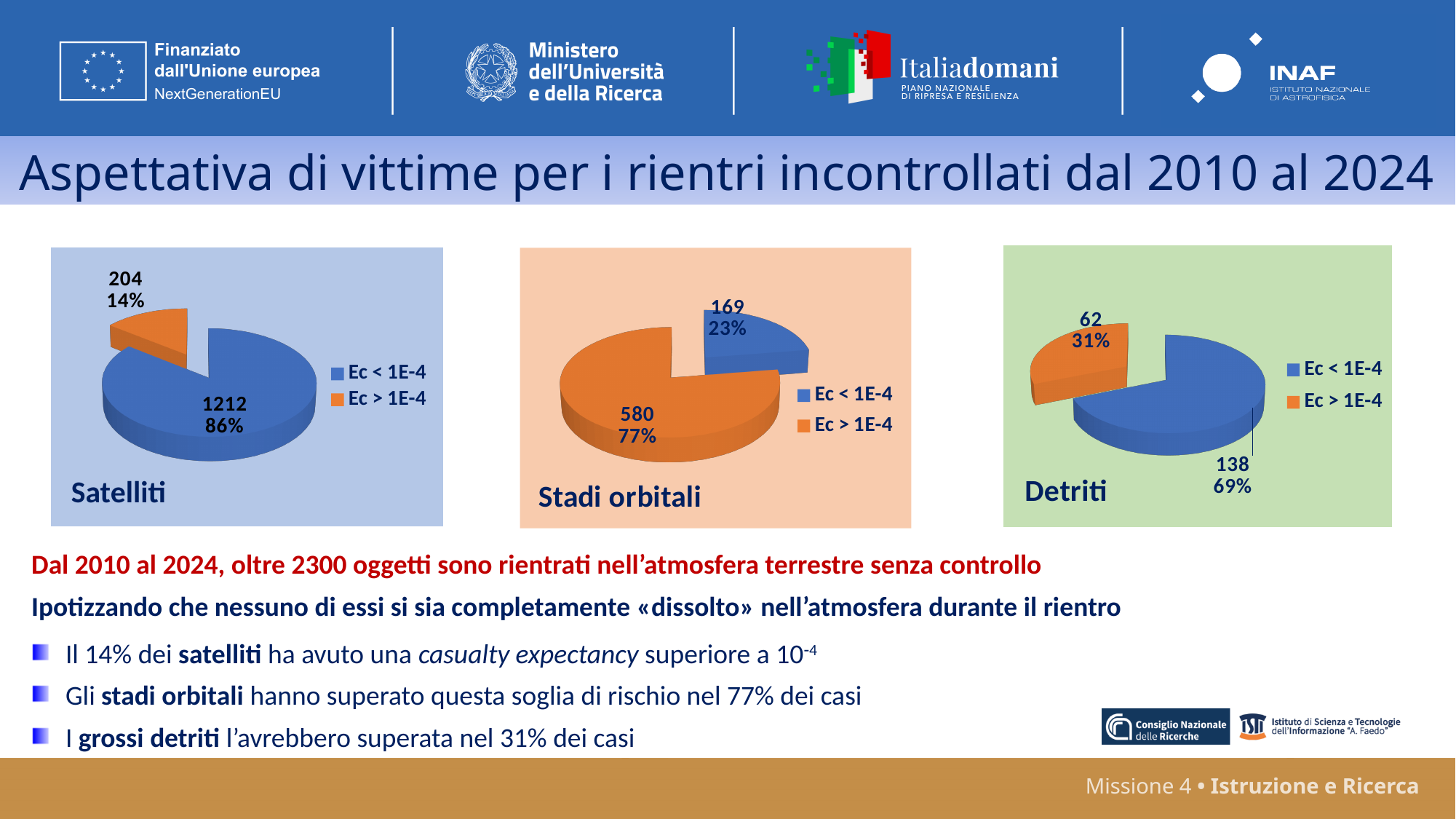
How many entries does the legend of the Detriti chart list? 2 In the Satelliti chart, what share of the pie is Ec < 1E-4? 86% In the Stadi orbitali chart, what share of the pie is Ec < 1E-4? 23% In the Satelliti chart, which slice is the largest? Ec < 1E-4 In the Detriti chart, what is the value for Ec < 1E-4? 138 In the Satelliti chart, what is the total of the two slices? 1416 In the Satelliti chart, what is the value for Ec > 1E-4? 204 In the Detriti chart, what share of the pie is Ec > 1E-4? 31% In the Detriti chart, what is the difference between the Ec < 1E-4 and Ec > 1E-4 values? 76 In the Stadi orbitali chart, what is the value for Ec > 1E-4? 580 What kind of chart is the Stadi orbitali chart? Pie chart In the Stadi orbitali chart, which slice is the smallest? Ec < 1E-4